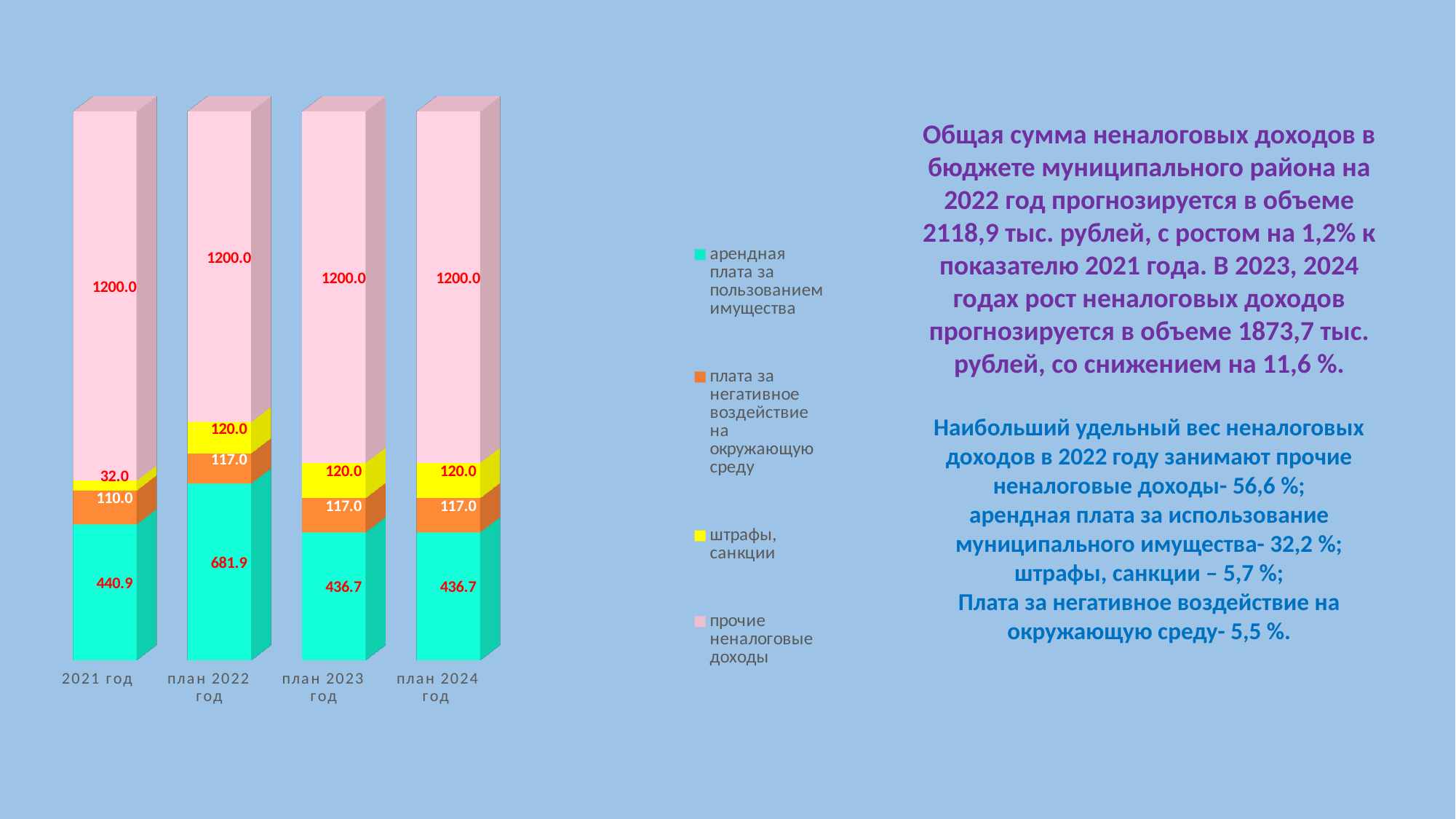
What is the difference between арендная плата за пользованием имущества in план 2022 год and in 2021 год? 241.0 What is the value of арендная плата за пользованием имущества for план 2022 год? 681.9 How many series does the legend list? 4 What is the value of штрафы, санкции for 2021 год? 32.0 What is the total of the stacked bar for 2021 год? 1782.9 Which year has the lowest value for штрафы, санкции? 2021 год What is the value of прочие неналоговые доходы for план 2024 год? 1200.0 How many categories (years) are shown on the x axis? 4 Which is larger: плата за негативное воздействие на окружающую среду in 2021 год or in план 2022 год? план 2022 год What is the total of the stacked bar for план 2022 год? 2118.9 Which year has the highest value for арендная плата за пользованием имущества? план 2022 год What is the value of плата за негативное воздействие на окружающую среду for план 2023 год? 117.0